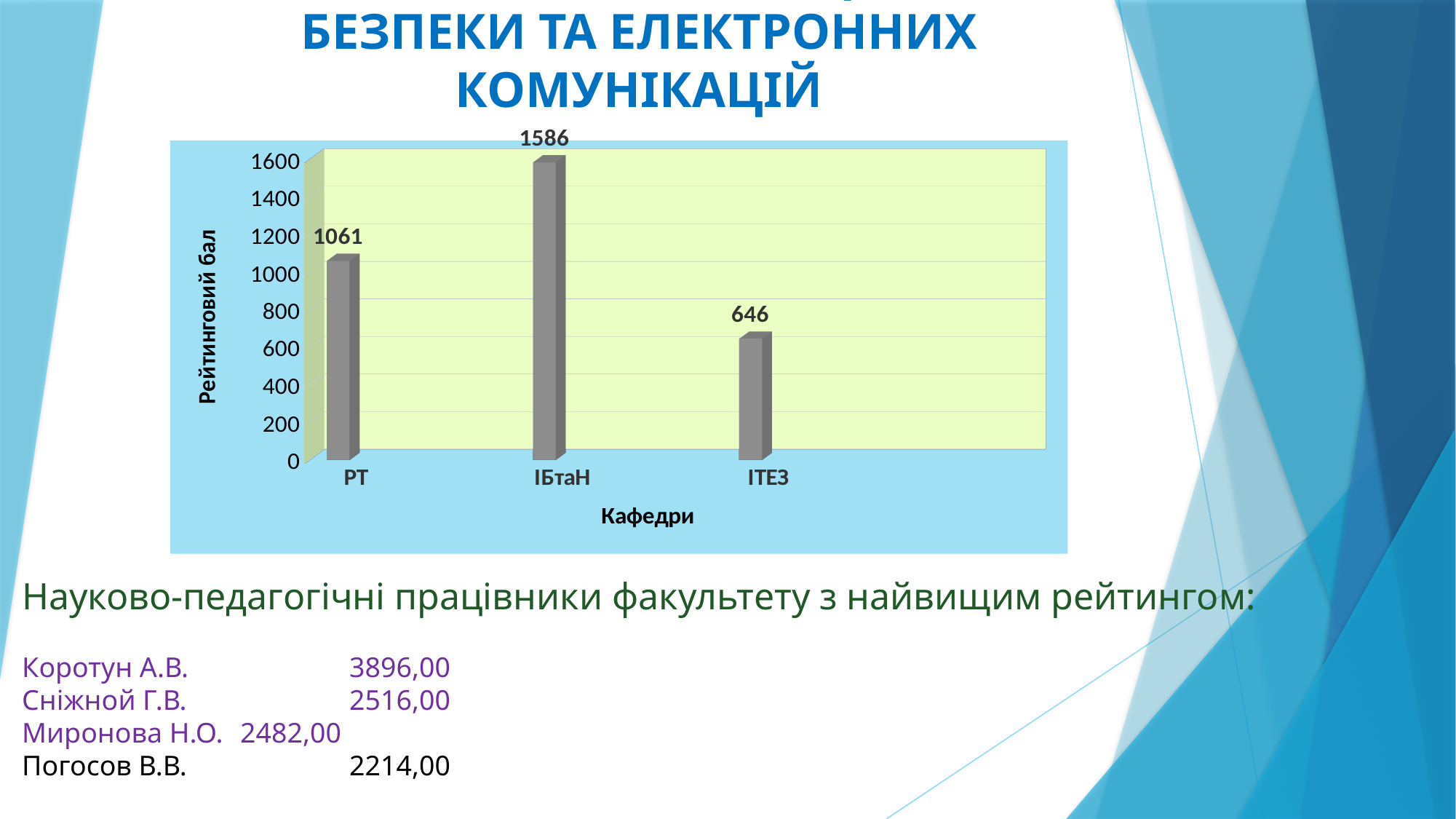
What is the difference between the rating scores of ІБтаН and РТ? 525 What is the label of the vertical axis of the chart? Рейтинговий бал Which has a higher rating score, РТ or ІТЕЗ? РТ Which department has the lowest rating score? ІТЕЗ Which department has the highest rating score? ІБтаН How many departments are shown on the chart? 3 What is the rating score for the ІТЕЗ department? 646 What is the rating score for the РТ department? 1061 What kind of chart is shown on the slide? bar chart What is the rating score for the ІБтаН department? 1586 What is the difference between the rating scores of РТ and ІТЕЗ? 415 Is the value for ІТЕЗ greater or less than 800? less